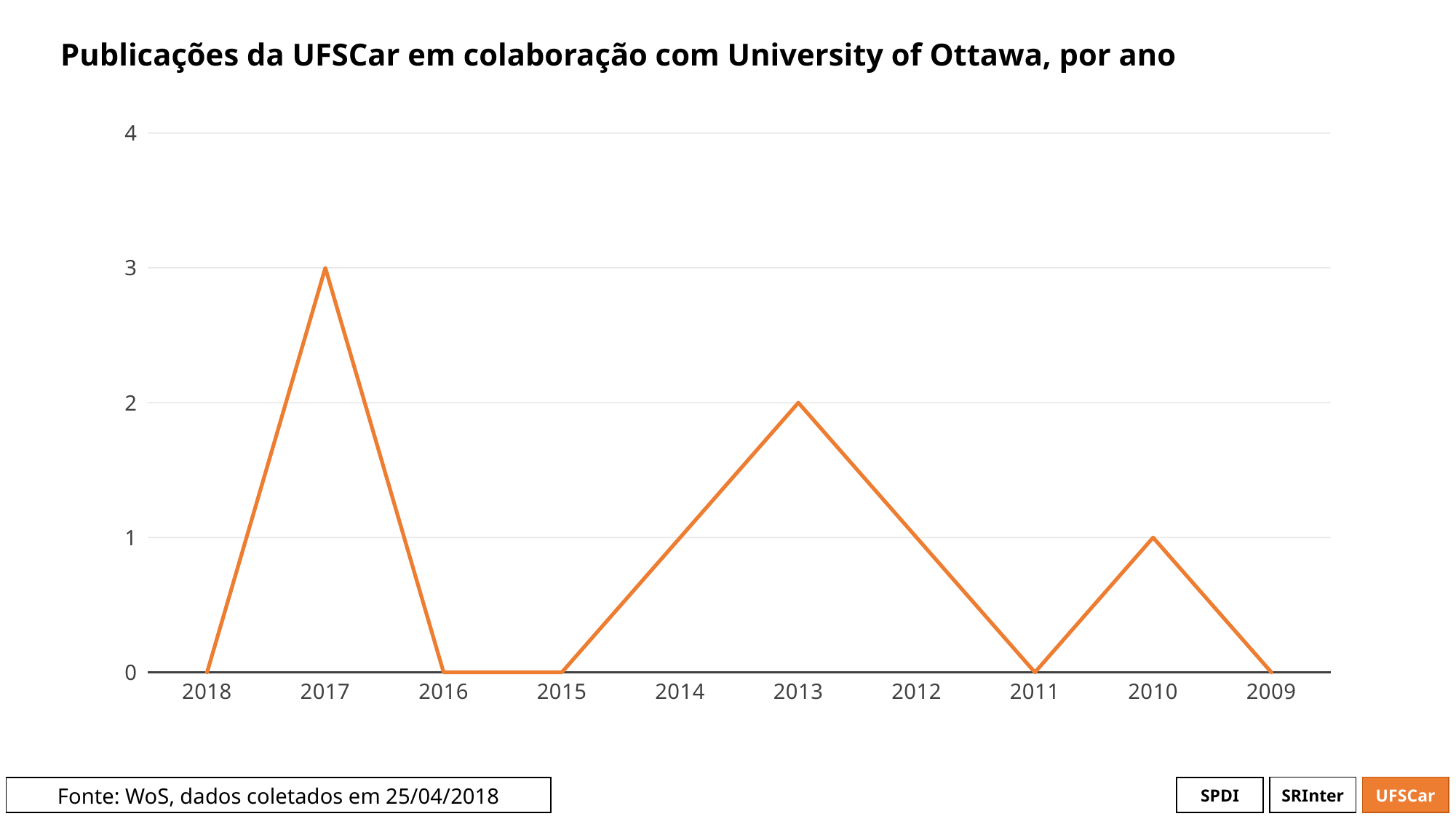
What is the value for 2016? 0 What is the value for 2017? 3 Is the value for 2017 greater or less than 2? greater What is the title of the chart? Publicações da UFSCar em colaboração com University of Ottawa, por ano What kind of chart is shown on the slide? line chart Moving along the x axis from 2013 to 2011, do the values rise or fall? fall What is the value for 2013? 2 Which is larger, the value for 2013 or the value for 2010? 2013 Which year has the highest value? 2017 How many years are shown on the x axis of the chart? 10 What is the difference between the values for 2017 and 2013? 1 What is the value for 2010? 1